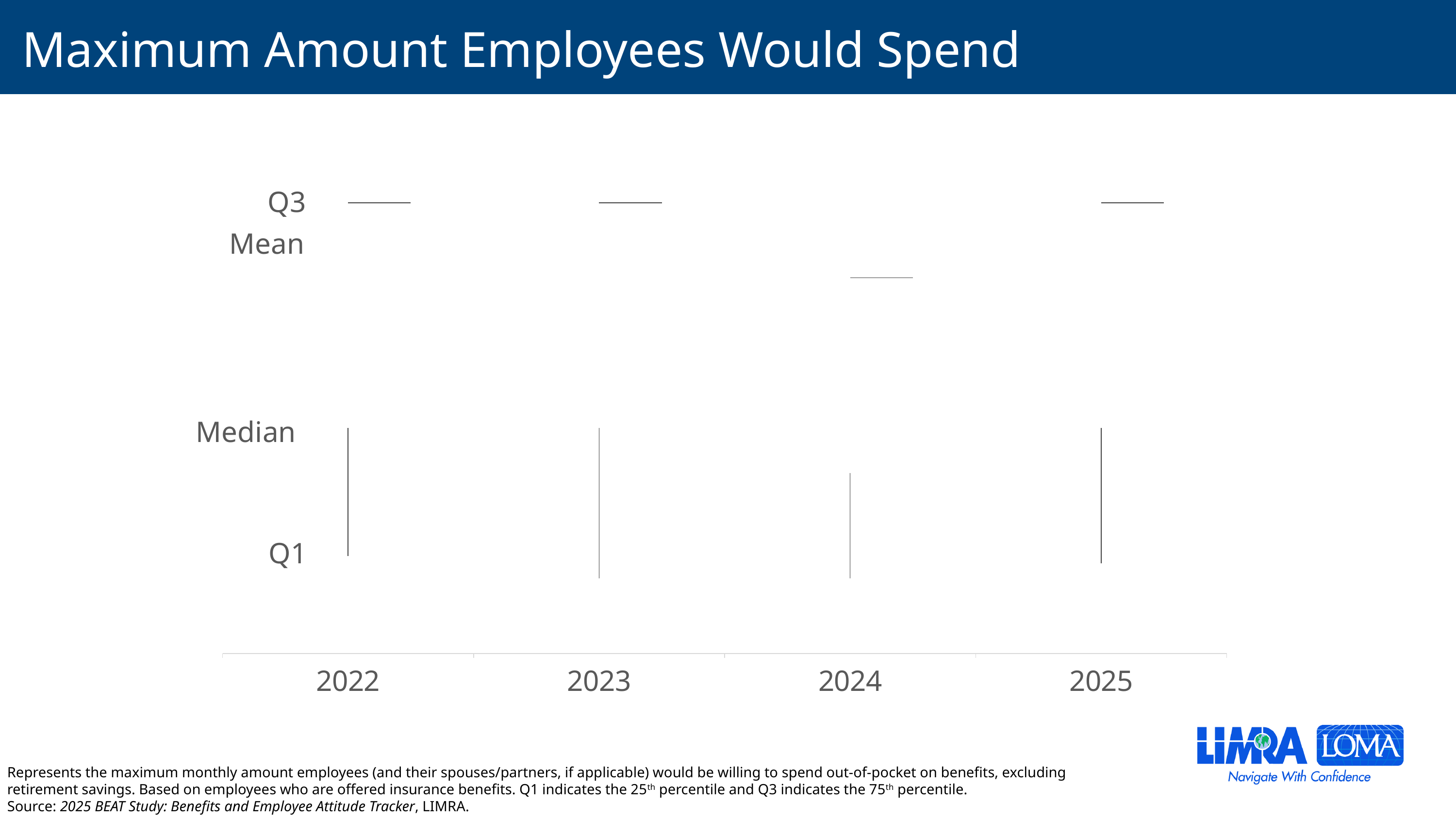
Which years are shown along the x axis of the chart? 2022, 2023, 2024, 2025 Is the top horizontal marker for 2024 positioned higher or lower than the one for 2023? lower Which year's top horizontal marker (Q3) sits lowest on the chart? 2024 What is the title of the chart on the slide? Maximum Amount Employees Would Spend Which year's vertical line is positioned lowest on the chart? 2024 How many years are shown along the x axis of the chart? 4